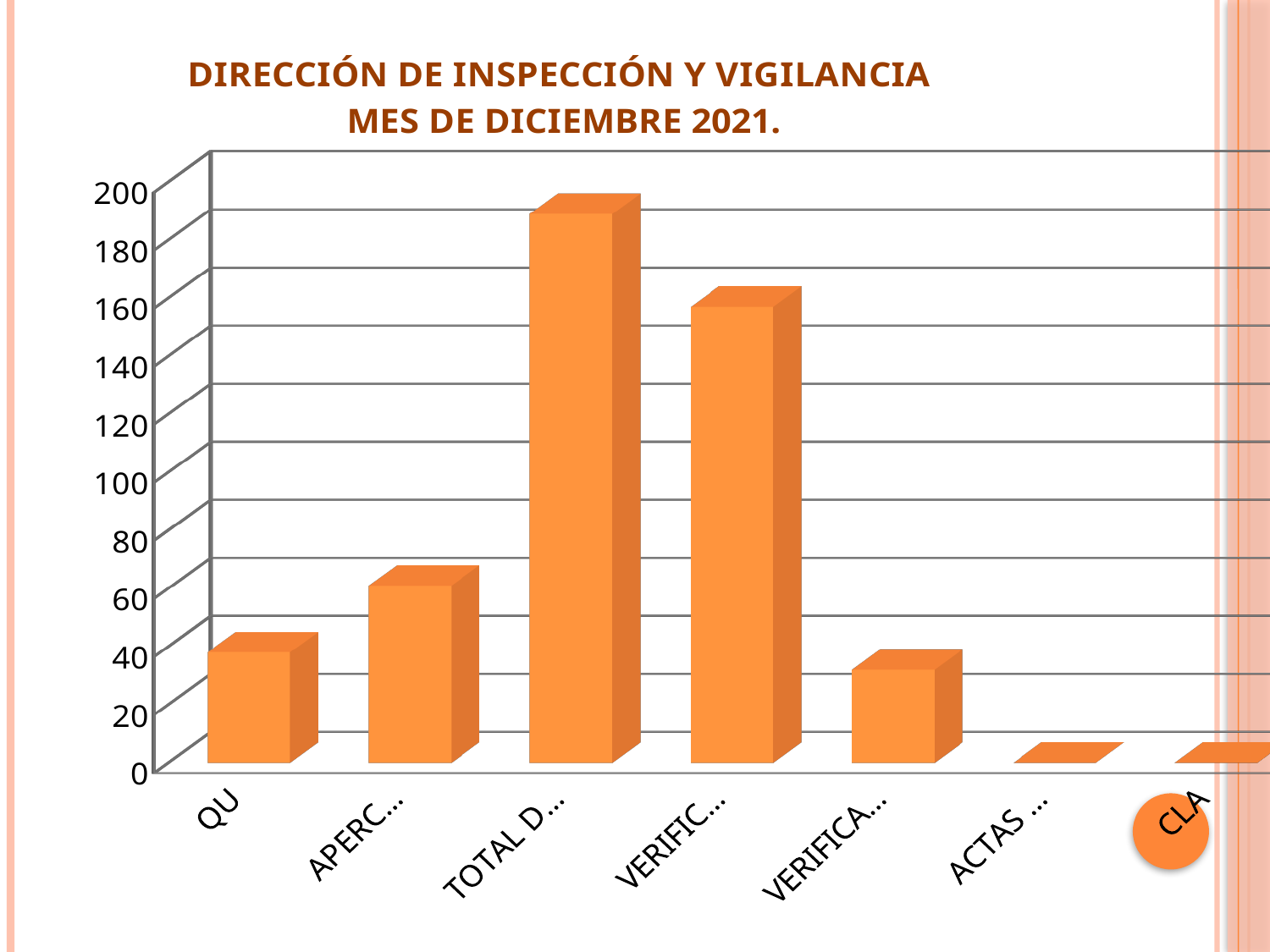
Which category has the tallest bar? TOTAL D... (the third bar) Is the value for the fourth bar (VERIFIC...) greater or less than 140? greater Which is larger, the third bar (TOTAL D...) or the fourth bar (VERIFIC...)? the third bar (TOTAL D...) Is the value for the third bar (TOTAL D...) greater or less than 160? greater Is the value for the first bar (QU) greater or less than 20? greater What kind of chart is shown on the slide? bar chart What colour are the bars in the chart? orange How many categories (bars) are shown along the x axis? 7 What is the title of the chart? DIRECCIÓN DE INSPECCIÓN Y VIGILANCIA MES DE DICIEMBRE 2021.